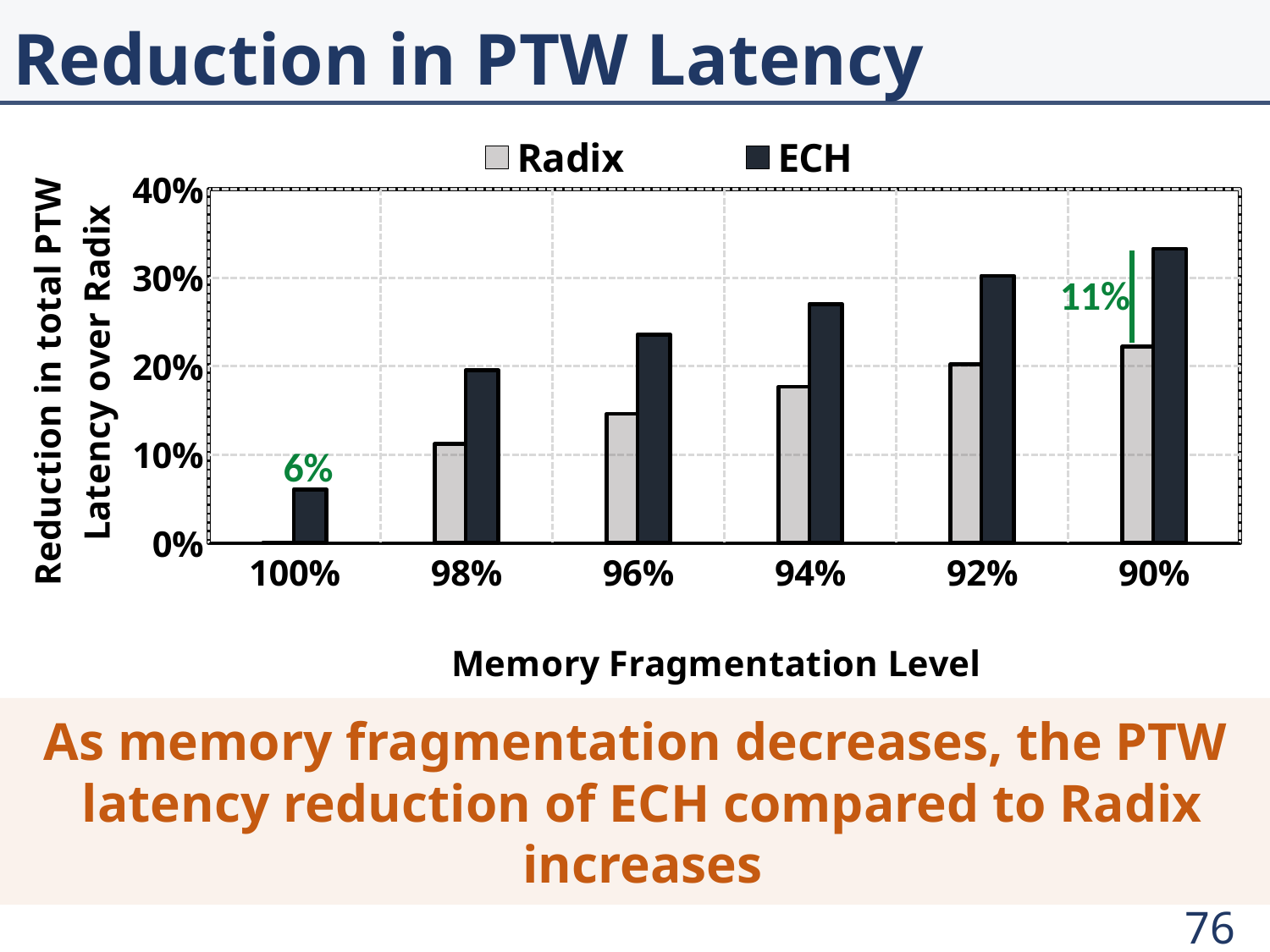
What is the labelled value for ECH at the 100% memory fragmentation level? 6% What gap between the ECH and Radix bars is annotated at the 90% memory fragmentation level? 11% How many series does the legend list? 2 At which memory fragmentation level is the ECH bar lowest? 100% At the 94% memory fragmentation level, which series has the larger value, Radix or ECH? ECH Do the ECH values rise or fall moving from 100% to 90% along the x axis? rise Is the value for ECH at the 94% memory fragmentation level greater or less than 20%? greater At which memory fragmentation level is the ECH bar highest? 90% What kind of chart is shown on the slide? bar chart Is the value for Radix at the 96% memory fragmentation level greater or less than 20%? less Is the value for ECH at the 90% memory fragmentation level greater or less than 30%? greater How many memory fragmentation levels are shown on the x axis? 6